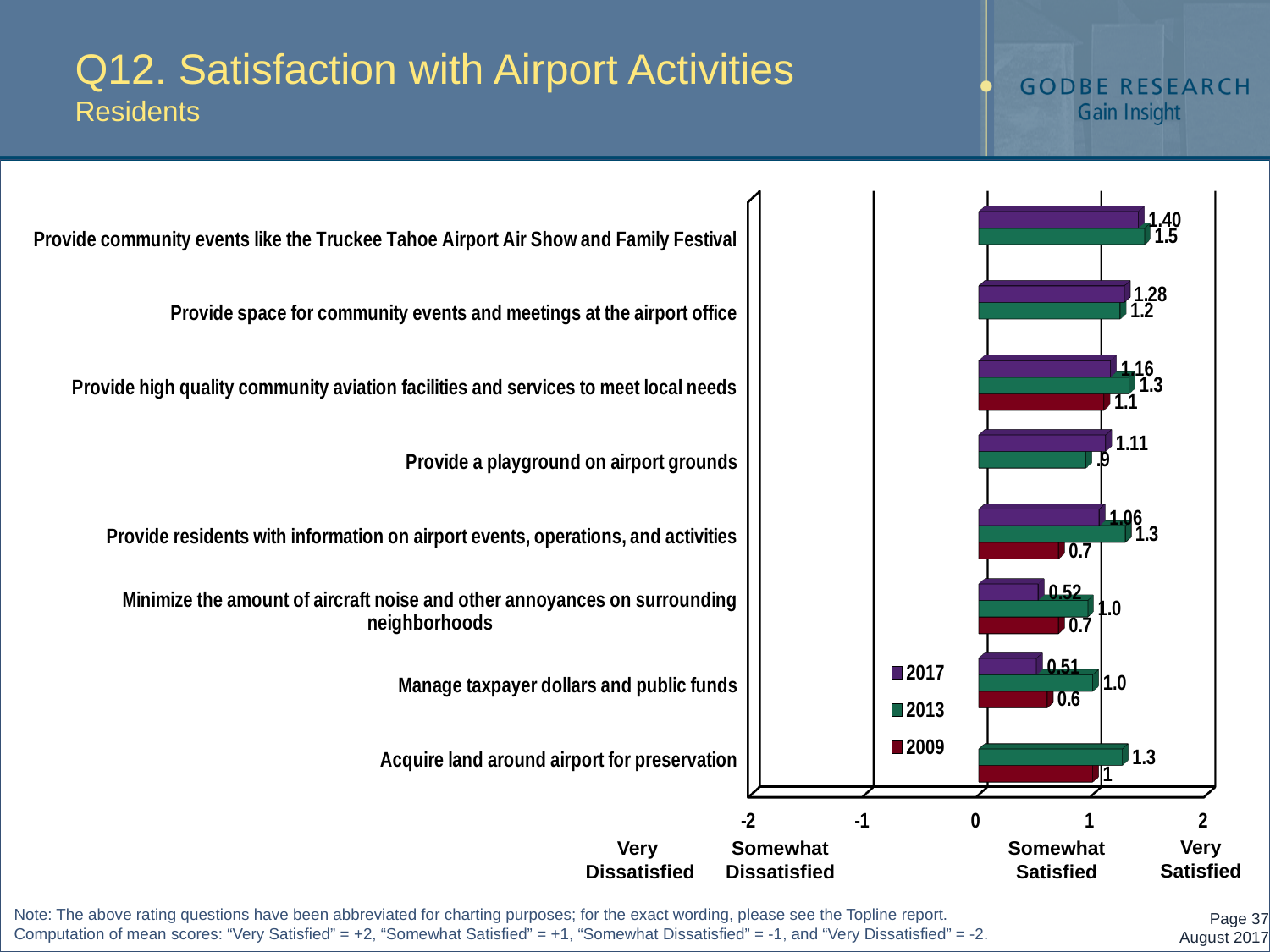
For "Provide space for community events and meetings at the airport office", which year has the higher mean score, 2017 or 2013? 2017 What type of chart is shown on the slide? Bar chart Is the 2017 mean score for "Minimize the amount of aircraft noise and other annoyances on surrounding neighborhoods" greater or less than 1? less Which activity has the highest 2017 mean score? Provide community events like the Truckee Tahoe Airport Air Show and Family Festival How many airport activities are listed on the chart? 8 What is the 2009 mean score for "Manage taxpayer dollars and public funds"? 0.6 Which activity has no 2017 bar shown? Acquire land around airport for preservation For "Provide high quality community aviation facilities and services to meet local needs", what is the difference between the 2013 and 2009 mean scores? 0.2 Which activity has the lowest 2017 mean score? Manage taxpayer dollars and public funds What is the 2017 mean score for "Provide community events like the Truckee Tahoe Airport Air Show and Family Festival"? 1.40 How many survey years does the legend list? 3 What is the 2013 mean score for "Provide a playground on airport grounds"? .9